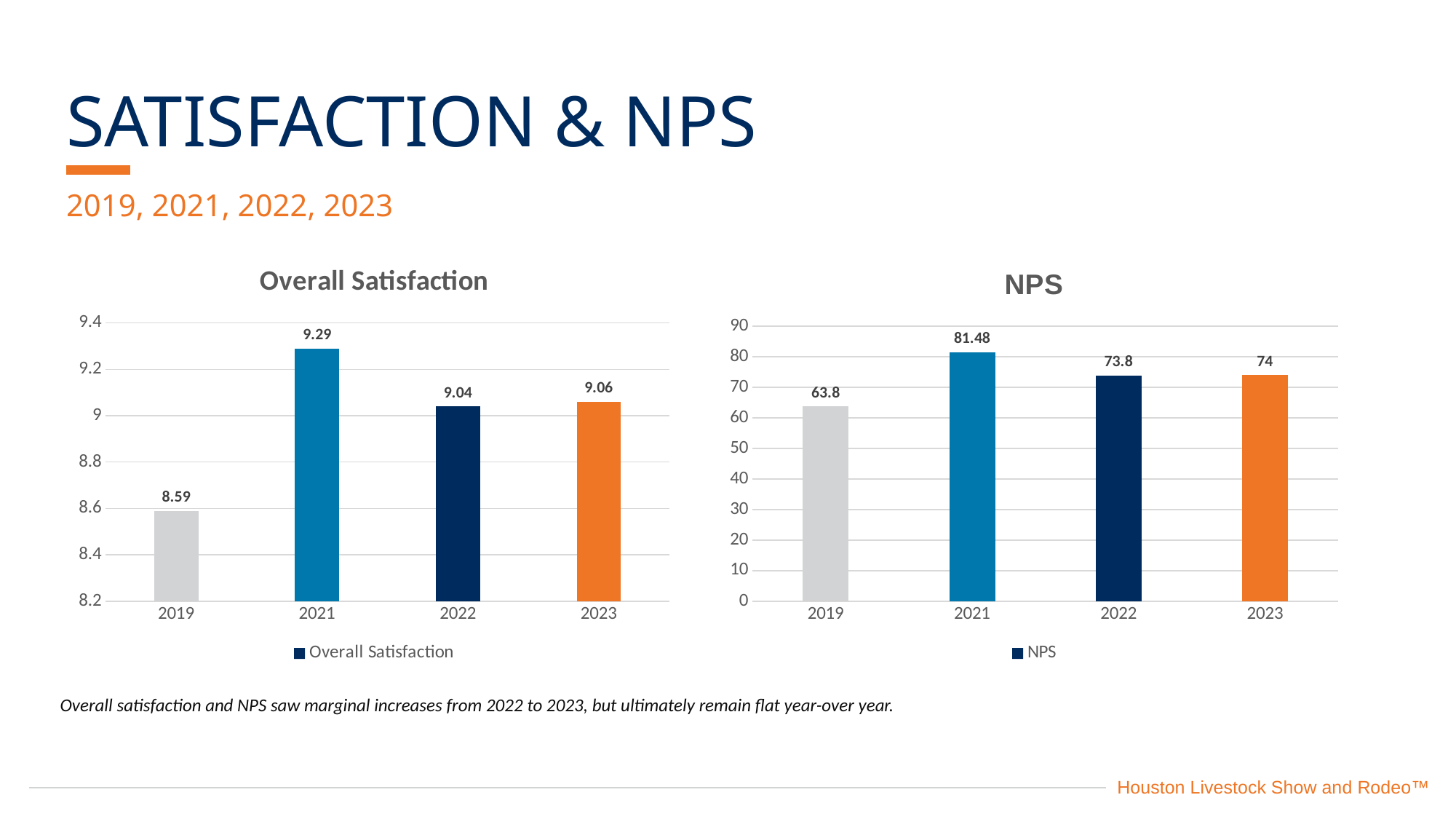
In the NPS chart, what is the difference between the 2021 and 2022 values? 7.68 In the Overall Satisfaction chart, which is larger, the value for 2022 or the value for 2023? 2023 In the NPS chart, is the value for 2019 greater or less than 70? less In the Overall Satisfaction chart, what is the value for 2021? 9.29 How many series does the legend of the NPS chart list? 1 In the NPS chart, what is the value for 2019? 63.8 In the Overall Satisfaction chart, which year has the lowest value? 2019 In the NPS chart, what is the value for 2023? 74 In the NPS chart, which year has the highest value? 2021 How many years are shown in the NPS chart? 4 In the Overall Satisfaction chart, what is the difference between the 2021 and 2019 values? 0.7 What kind of chart is the Overall Satisfaction chart? bar chart